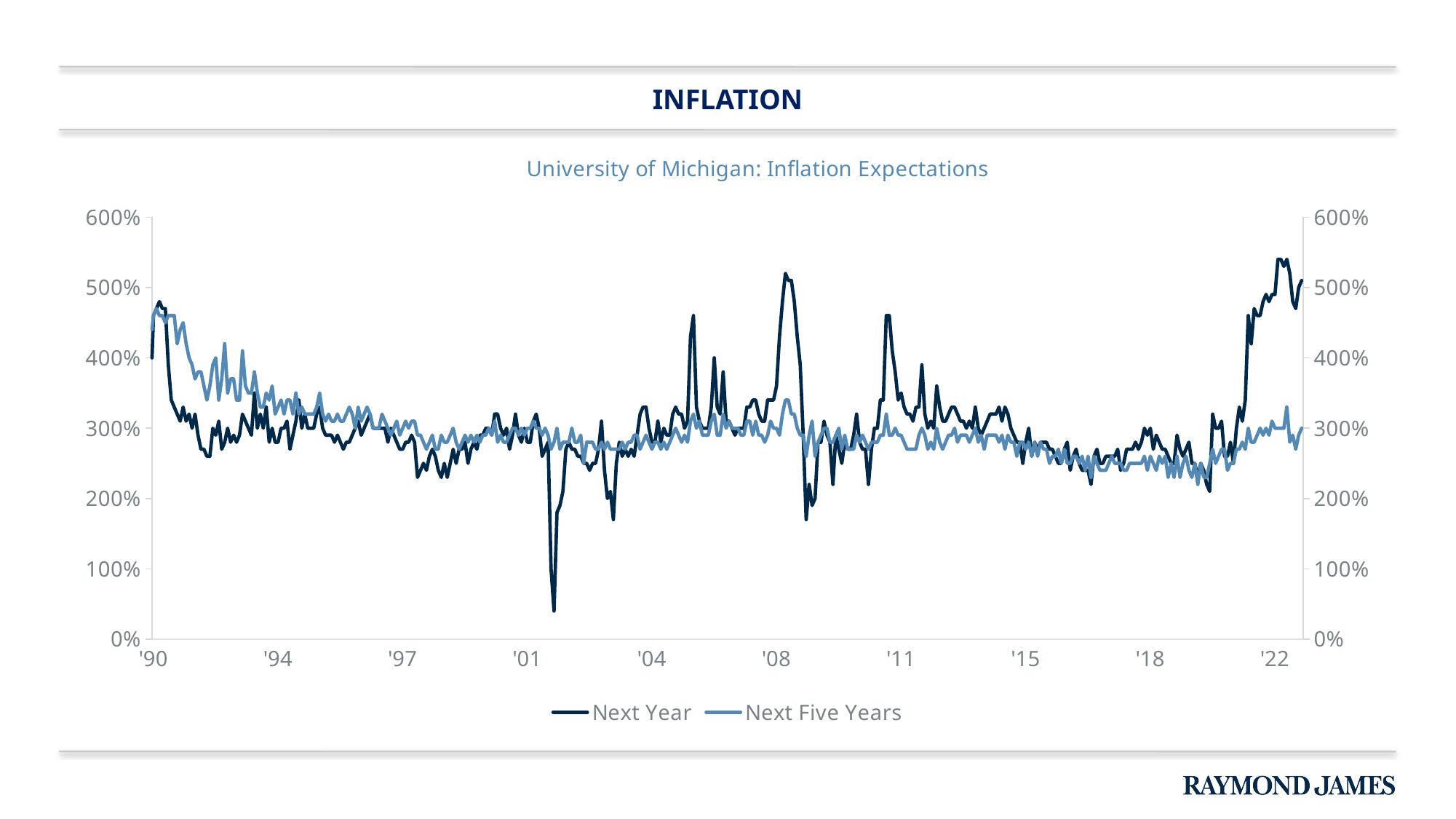
How many series does the legend list? 2 Is the peak of the Next Year series around 2008 greater or less than 500%? greater Which series reaches the highest value anywhere on the chart? Next Year What kind of chart is shown on the slide? line chart Which series reaches the lowest value anywhere on the chart? Next Year Is the lowest value of the Next Year series, around 2001, greater or less than 100%? less What is the title of the chart? University of Michigan: Inflation Expectations Around 2022, which series is higher, Next Year or Next Five Years? Next Year Is the highest value of the Next Five Years series around 2022 greater or less than 400%? less Which series is drawn in the lighter blue line? Next Five Years